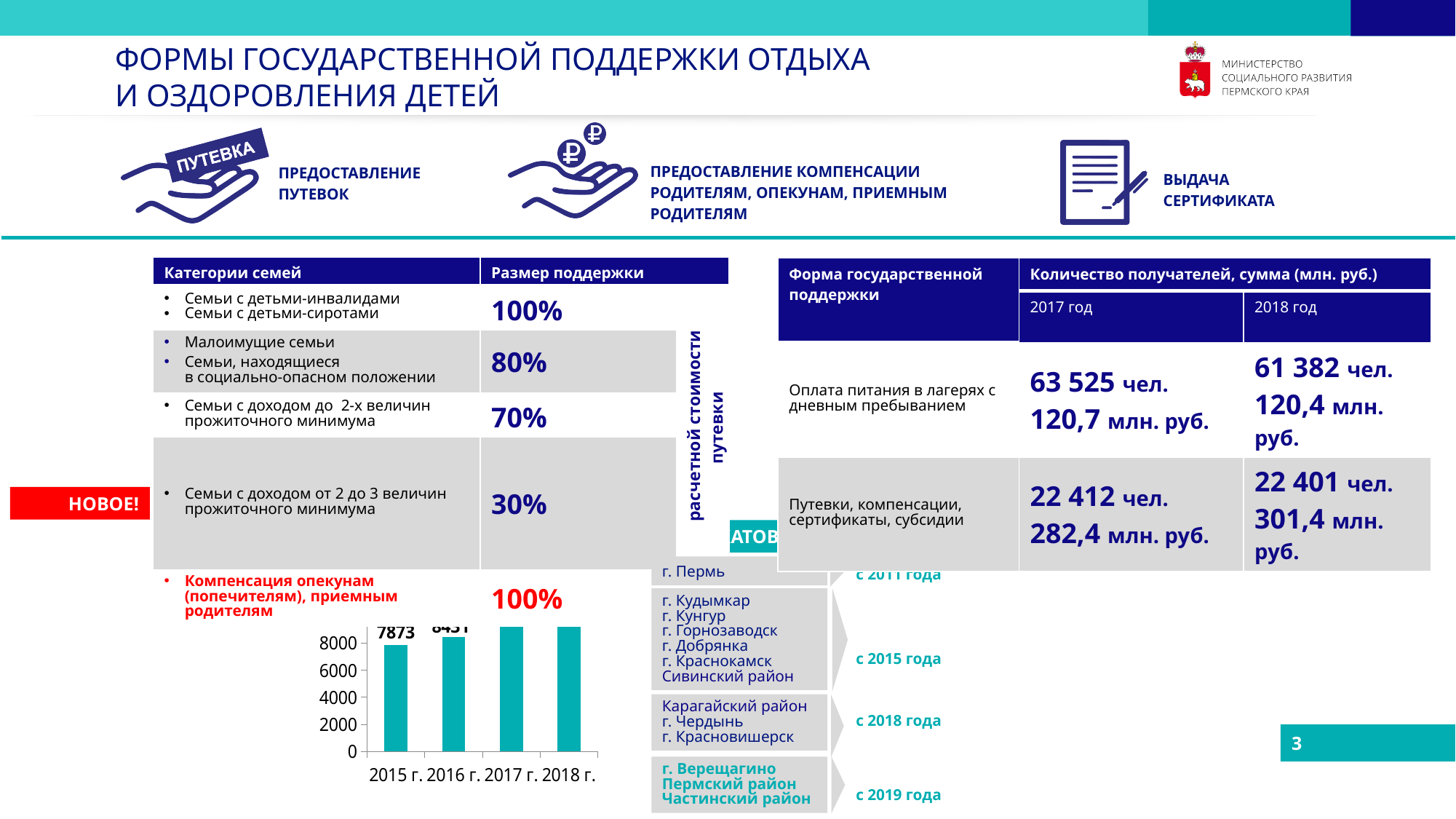
Which is larger in the bar chart, the value for 2015 г. or the value for 2017 г.? 2017 г. How many years (categories) are shown on the x axis of the bar chart? 4 Is the value for 2018 г. in the bar chart greater or less than 8000? greater Is the value for 2015 г. in the bar chart greater or less than 8000? less What is the highest tick value shown on the vertical axis of the bar chart? 8000 Do the values in the bar chart rise or fall from 2015 г. to 2018 г.? rise Is the value for 2017 г. in the bar chart greater or less than 8000? greater What is the value shown for 2015 г. in the bar chart? 7873 What kind of chart is shown at the bottom of the slide? bar chart What is the first year label on the x axis of the bar chart? 2015 г. Which is larger in the bar chart, the value for 2016 г. or the value for 2018 г.? 2018 г. Which year has the lowest bar in the bar chart? 2015 г.